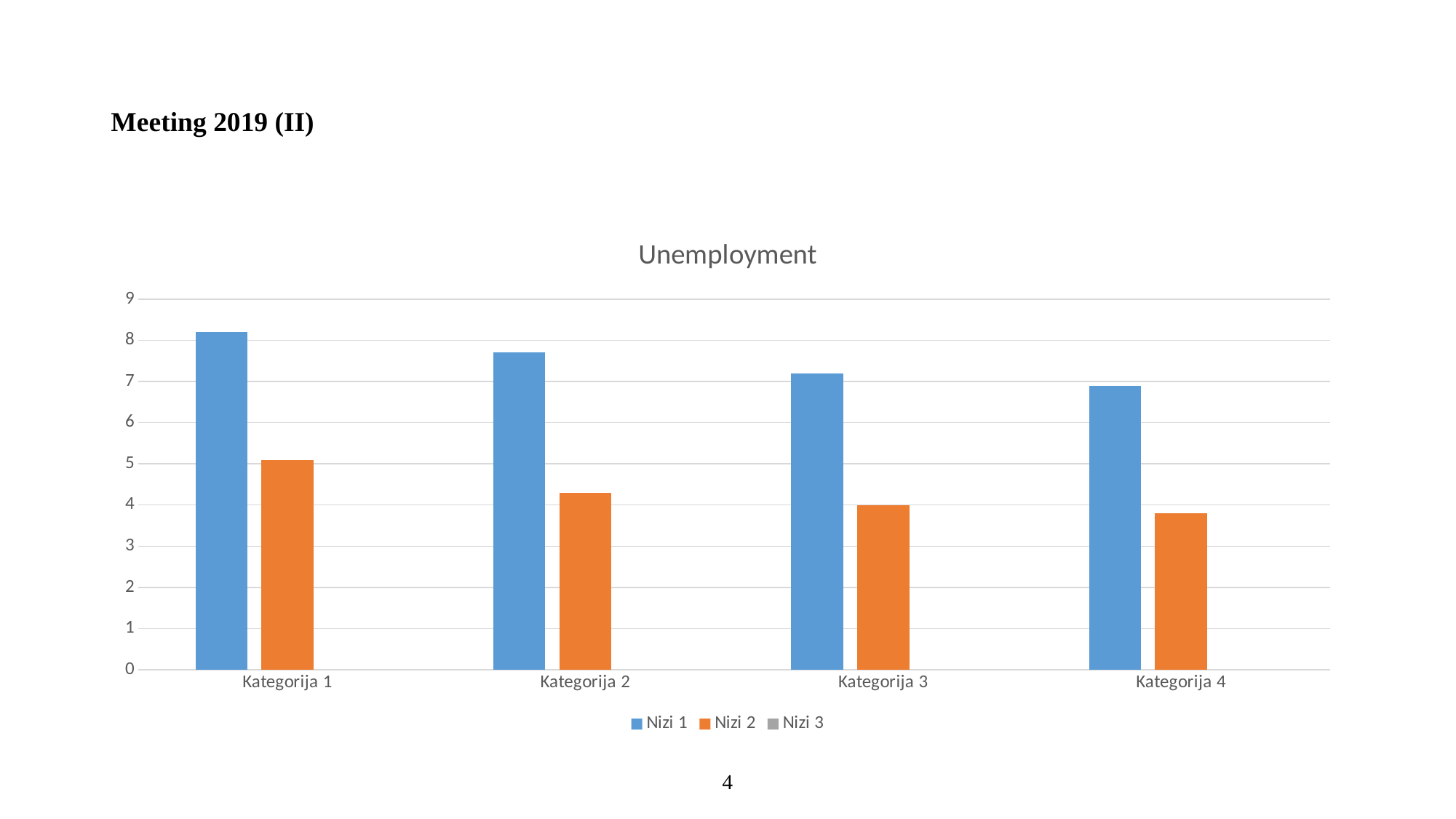
Which category has the lowest value for Nizi 2? Kategorija 4 How many series does the legend list? 3 Which category has the highest value for Nizi 1? Kategorija 1 Which is larger in Kategorija 2, Nizi 1 or Nizi 2? Nizi 1 Do the Nizi 1 values rise or fall from Kategorija 1 to Kategorija 4? fall What is the title of the chart? Unemployment What type of chart is shown on the slide? bar chart Is the value for Nizi 2 in Kategorija 4 greater or less than 4? less How many categories are shown on the x axis? 4 Is the value for Nizi 1 in Kategorija 1 greater or less than 8? greater